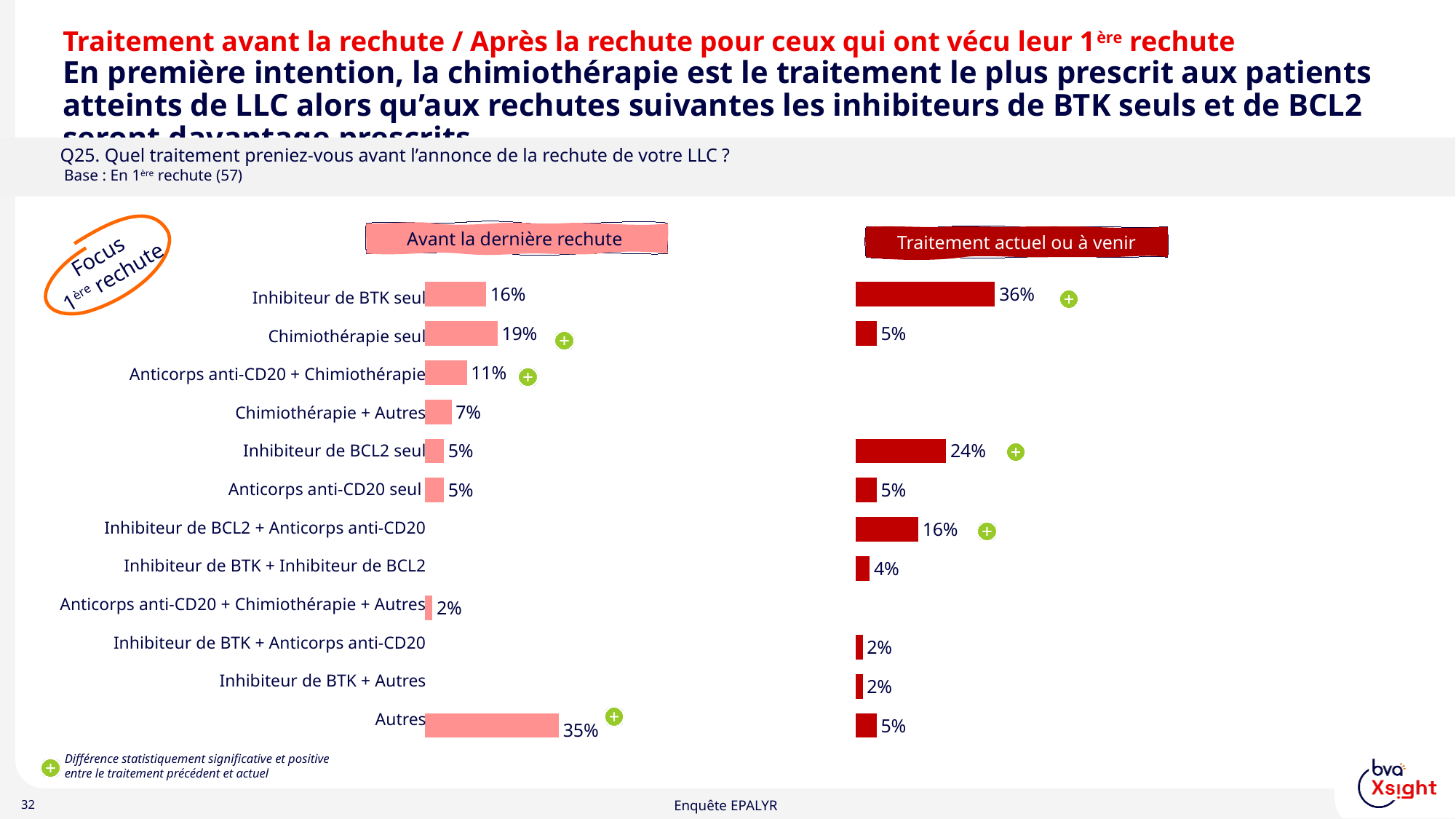
In the 'Avant la dernière rechute' chart, which category has the highest value? Autres In the 'Traitement actuel ou à venir' chart, which is larger: Inhibiteur de BCL2 seul or Inhibiteur de BCL2 + Anticorps anti-CD20? Inhibiteur de BCL2 seul For Chimiothérapie seul, which is larger: the 'Avant la dernière rechute' value or the 'Traitement actuel ou à venir' value? Avant la dernière rechute What is the difference between the 'Traitement actuel ou à venir' value and the 'Avant la dernière rechute' value for Inhibiteur de BTK seul? 20 percentage points In the 'Avant la dernière rechute' chart, what is the difference between Chimiothérapie seul and Anticorps anti-CD20 + Chimiothérapie? 8 percentage points In the 'Traitement actuel ou à venir' chart, which category has the highest value? Inhibiteur de BTK seul In the 'Avant la dernière rechute' chart, which category has the lowest value? Anticorps anti-CD20 + Chimiothérapie + Autres In the 'Traitement actuel ou à venir' chart, what is the value for Inhibiteur de BCL2 + Anticorps anti-CD20? 16% In the 'Traitement actuel ou à venir' chart, what is the value for Inhibiteur de BTK + Inhibiteur de BCL2? 4% What kind of chart is used on this slide? Bar chart In the 'Traitement actuel ou à venir' chart, what is the value for Inhibiteur de BTK seul? 36% In the 'Avant la dernière rechute' chart, what is the value for Chimiothérapie seul? 19%